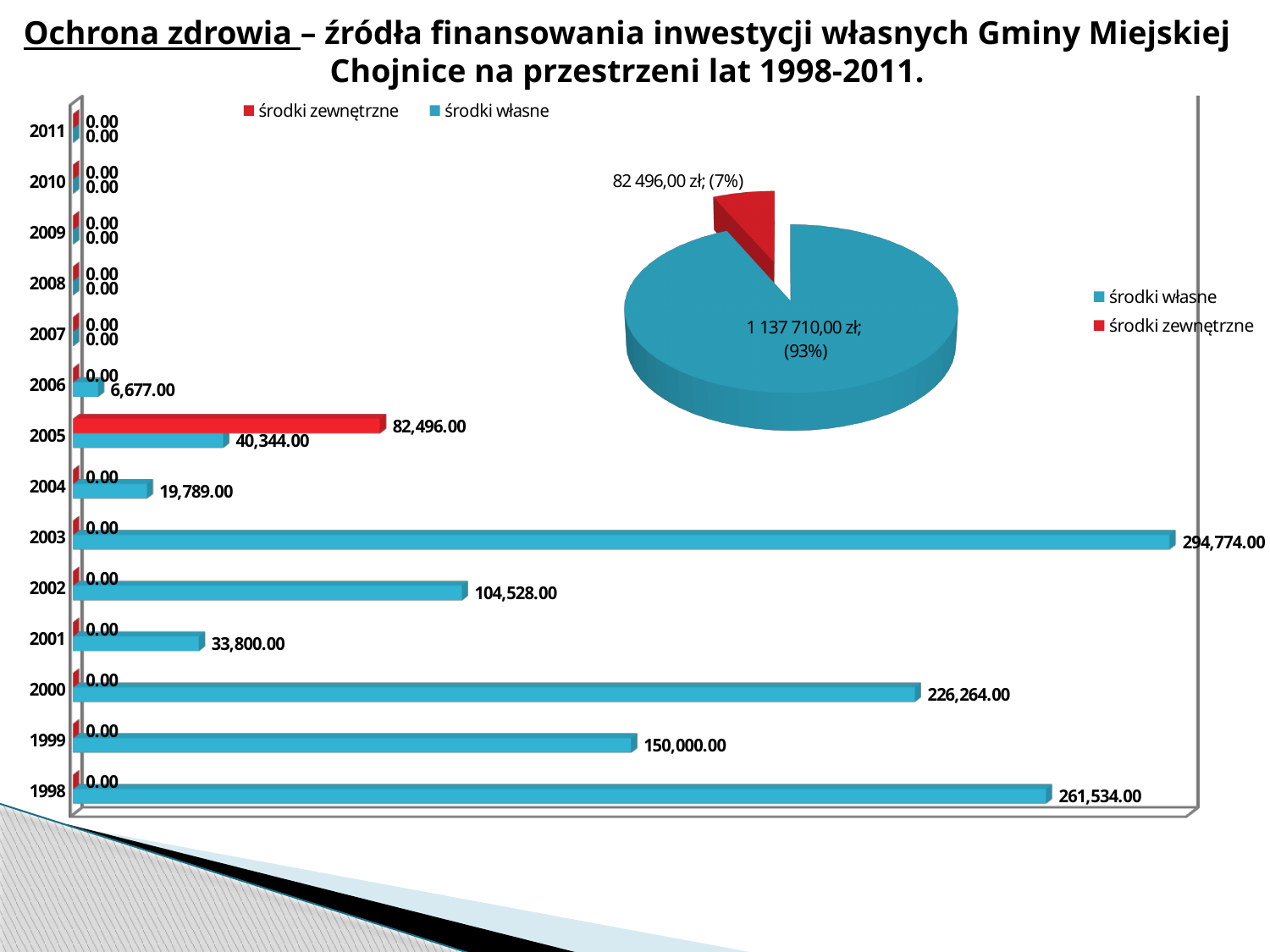
In the bar chart, what colour represents środki zewnętrzne? red In the bar chart, what is the difference between the środki własne values for 2003 and 1998? 33,240.00 How many years are shown on the bar chart? 14 In the bar chart, what is the value of środki zewnętrzne for 2005? 82,496.00 In the pie chart, what is the value shown for środki własne? 1 137 710,00 zł In the bar chart, which year has the larger środki własne value, 1999 or 2000? 2000 In the pie chart, what share does środki zewnętrzne have? 7% In the bar chart, for 2005, what is the difference between środki zewnętrzne and środki własne? 42,152.00 How many series does the bar chart's legend list? 2 In the bar chart, which year has the highest value of środki własne? 2003 In the bar chart, what is the value of środki własne for 2003? 294,774.00 What kind of chart is the chart on the left side of the slide? bar chart